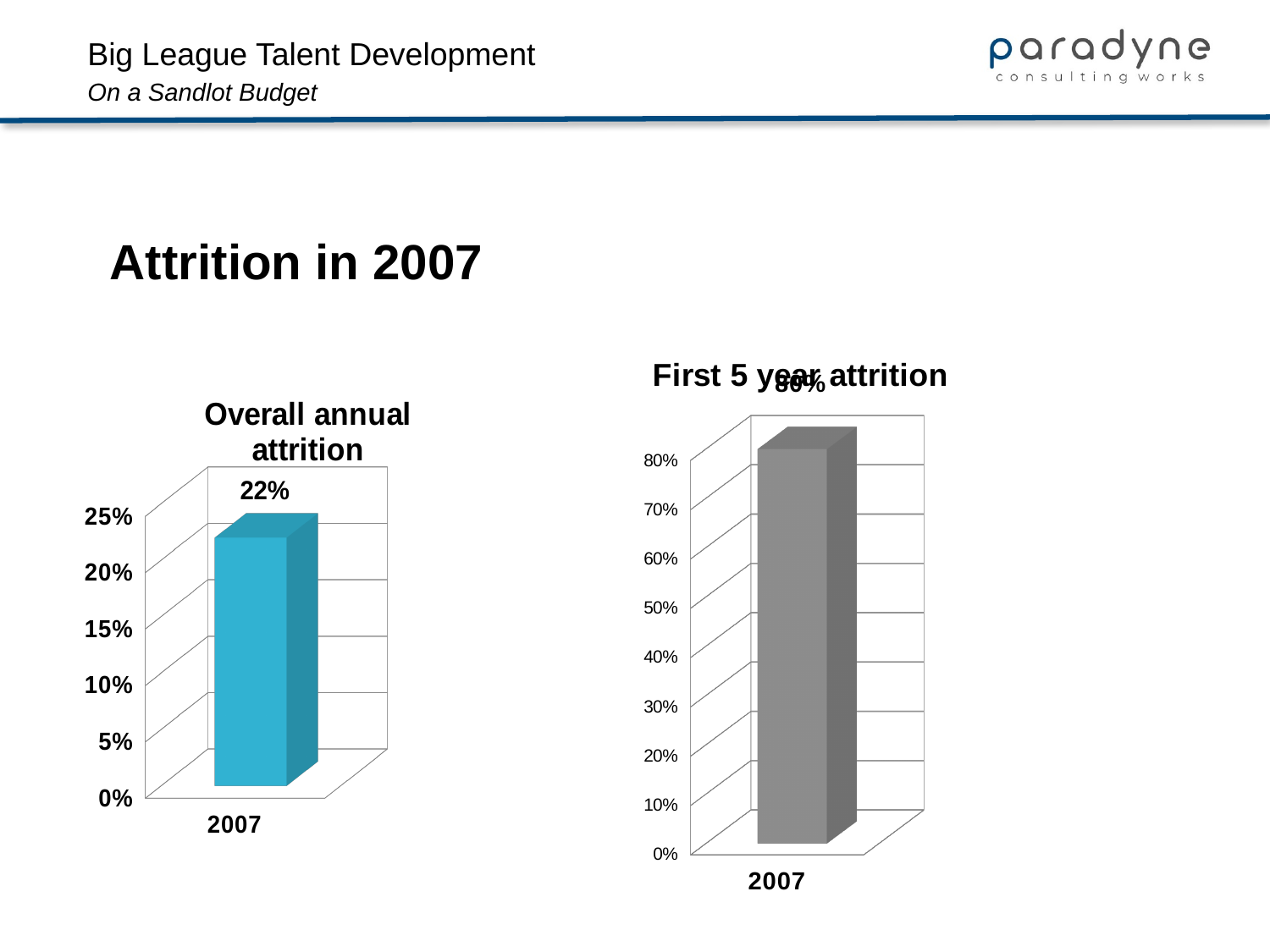
What is the highest value labelled on the y axis of the 'Overall annual attrition' chart? 25% Which chart shows the larger value for 2007, 'Overall annual attrition' or 'First 5 year attrition'? First 5 year attrition How many categories are shown on the x axis of the 'First 5 year attrition' chart? 1 What type of chart is the 'Overall annual attrition' chart? bar chart What is the title of the chart on the left side of the slide? Overall annual attrition In the 'Overall annual attrition' chart, is the value for 2007 greater or less than 25%? less In the 'First 5 year attrition' chart, is the value for 2007 greater or less than 50%? greater In the 'Overall annual attrition' chart, is the value for 2007 greater or less than 20%? greater How many categories are shown on the x axis of the 'Overall annual attrition' chart? 1 In the 'Overall annual attrition' chart, what is the value for 2007? 22% What type of chart is the 'First 5 year attrition' chart? bar chart